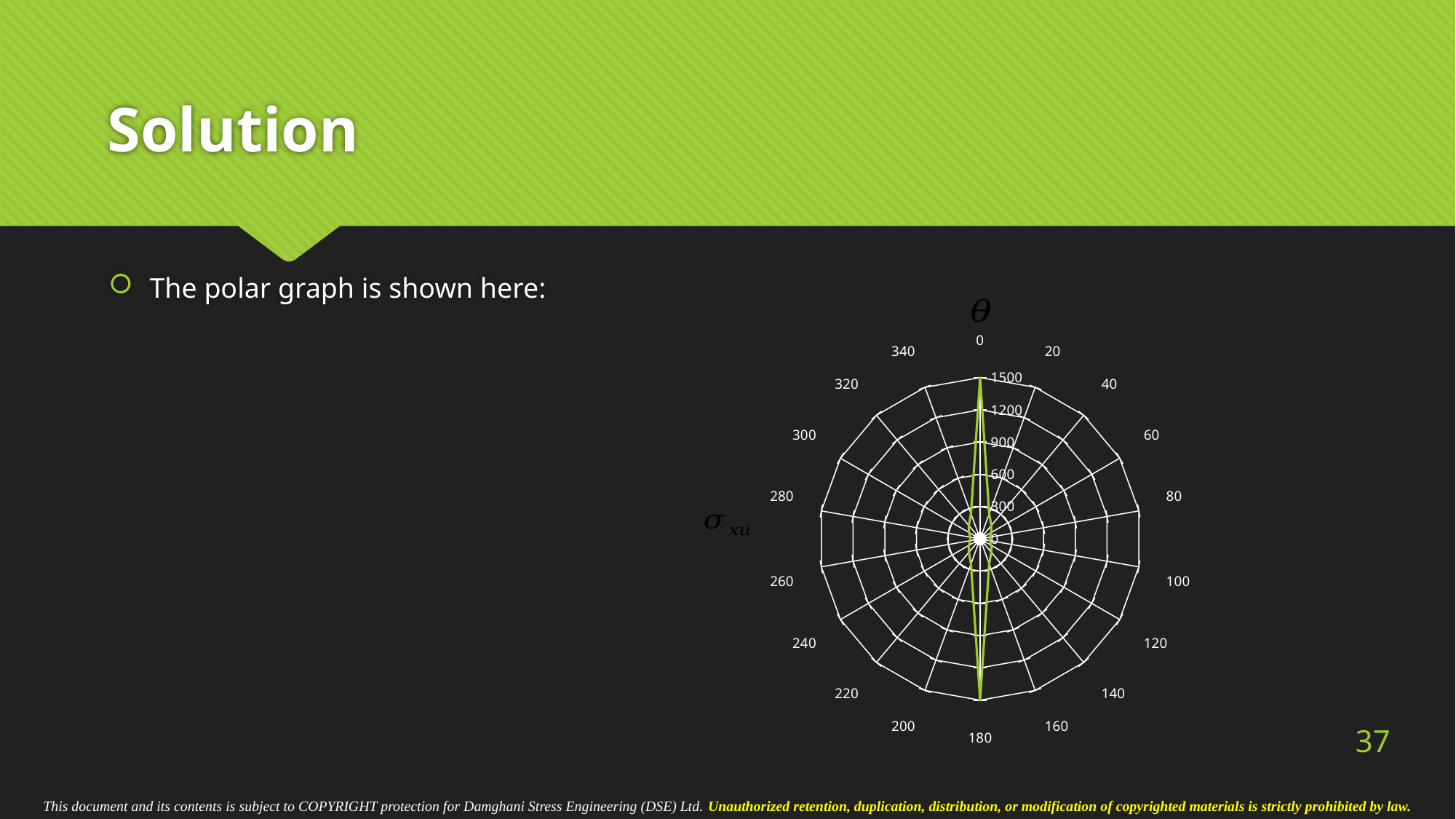
How many angle labels are printed around the polar chart? 18 Is the plotted value at angle 180 greater or less than 1200? greater How many plotted series are shown on the polar chart? 1 Which is larger, the plotted value at angle 0 or at angle 100? 0 Which is larger, the plotted value at angle 180 or at angle 280? 180 Is the plotted value at angle 80 greater or less than 300? less What is the smallest radial value labelled on the polar chart? 300 What symbol labels the angular axis at the top of the polar chart? θ What is the largest radial value labelled on the polar chart? 1500 Is the plotted value at angle 260 greater or less than 300? less What kind of chart is shown on the slide? Polar chart